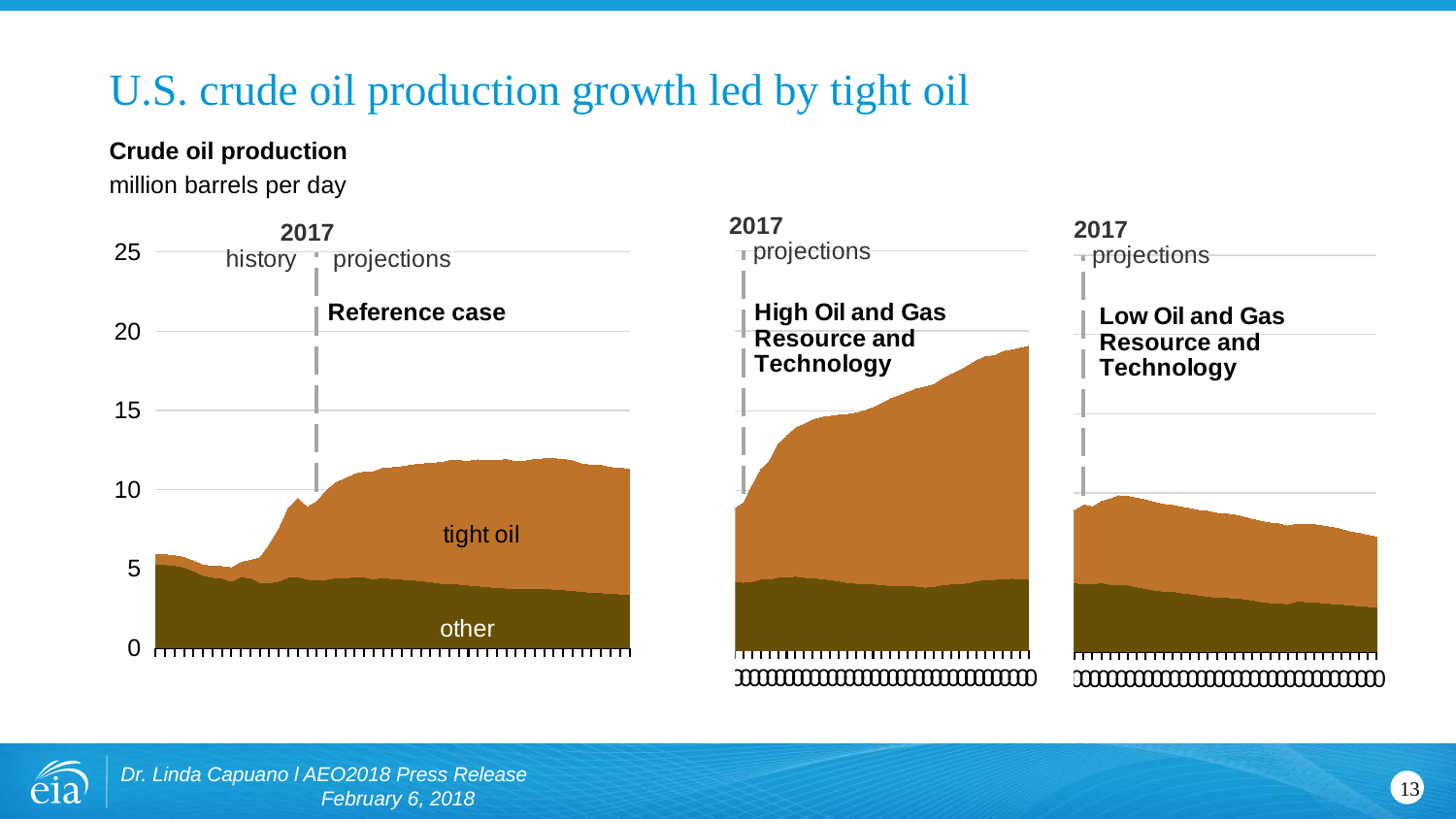
In the Low Oil and Gas Resource and Technology chart, is the total crude oil production at the end of the projection period greater or less than 10? less In the High Oil and Gas Resource and Technology chart, does total crude oil production rise or fall over the projection period? rise In the High Oil and Gas Resource and Technology chart, is the total crude oil production at the end of the projection period greater or less than 15? greater What unit is used for crude oil production on the slide? million barrels per day In the Reference case chart, is the total crude oil production at the end of the projection period greater or less than 10? greater What kind of chart is the Reference case chart? stacked area chart In the Reference case chart, how many series are plotted? 2 At the end of the projection period, which chart shows higher total crude oil production: the High Oil and Gas Resource and Technology chart or the Low Oil and Gas Resource and Technology chart? High Oil and Gas Resource and Technology How many charts are shown on the slide? 3 In the Reference case chart, which year marks the boundary between history and projections? 2017 In the Low Oil and Gas Resource and Technology chart, does total crude oil production rise or fall over the later part of the projection period? fall